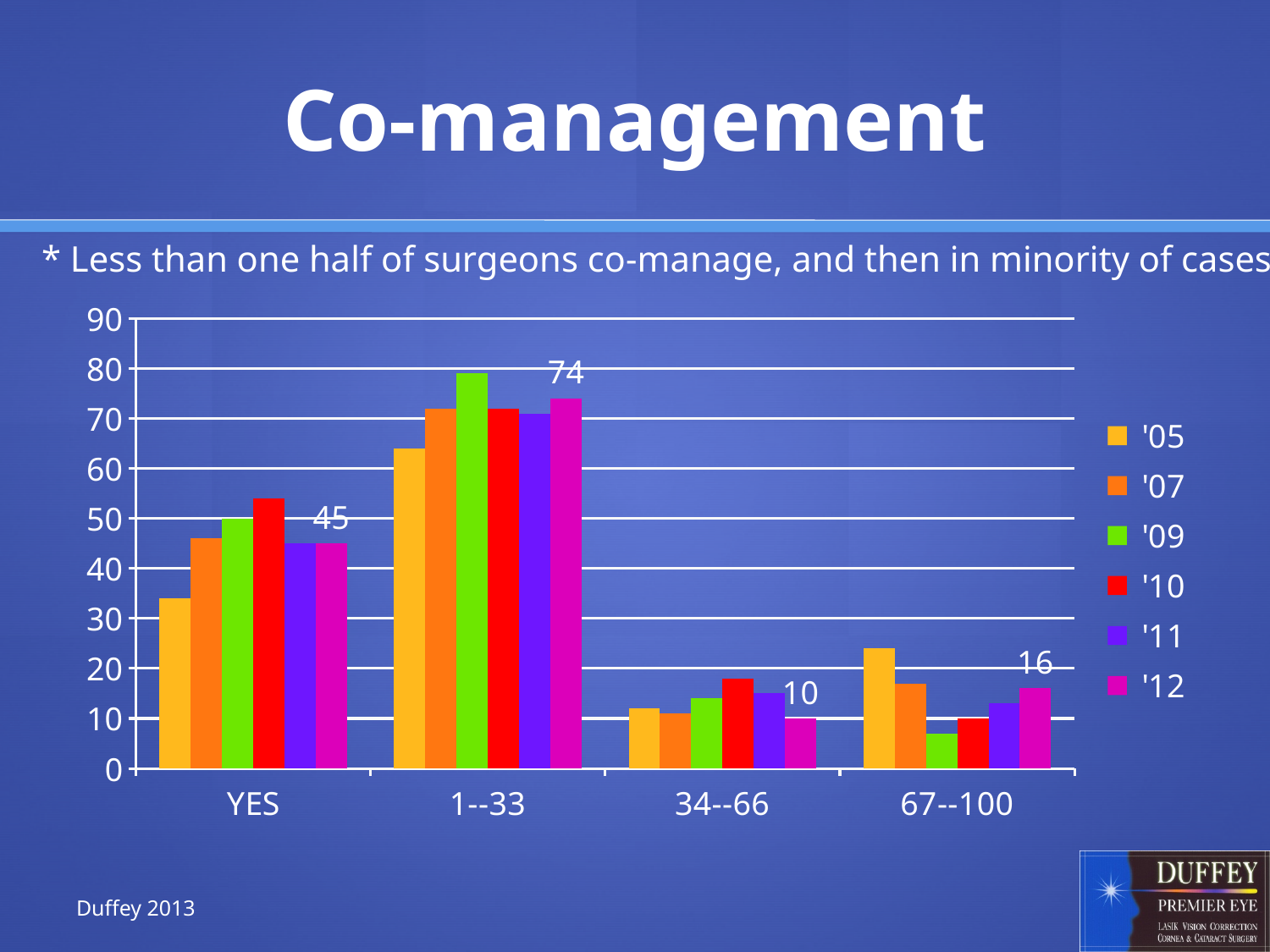
Which is larger for the '12 series: the value for YES or the value for 67--100? YES What is the value for '12 in the 1--33 category? 74 Which category has the highest value for the '12 series? 1--33 How many categories are shown on the x axis? 4 What is the difference between the '12 values for 1--33 and YES? 29 How many series does the legend list? 6 Is the value for '09 in the 1--33 category greater or less than 70? greater What is the value for '12 in the 34--66 category? 10 What kind of chart is shown on the slide? bar chart What is the value for '12 in the YES category? 45 Which category has the lowest value for the '12 series? 34--66 Is the value for '05 in the YES category greater or less than 40? less